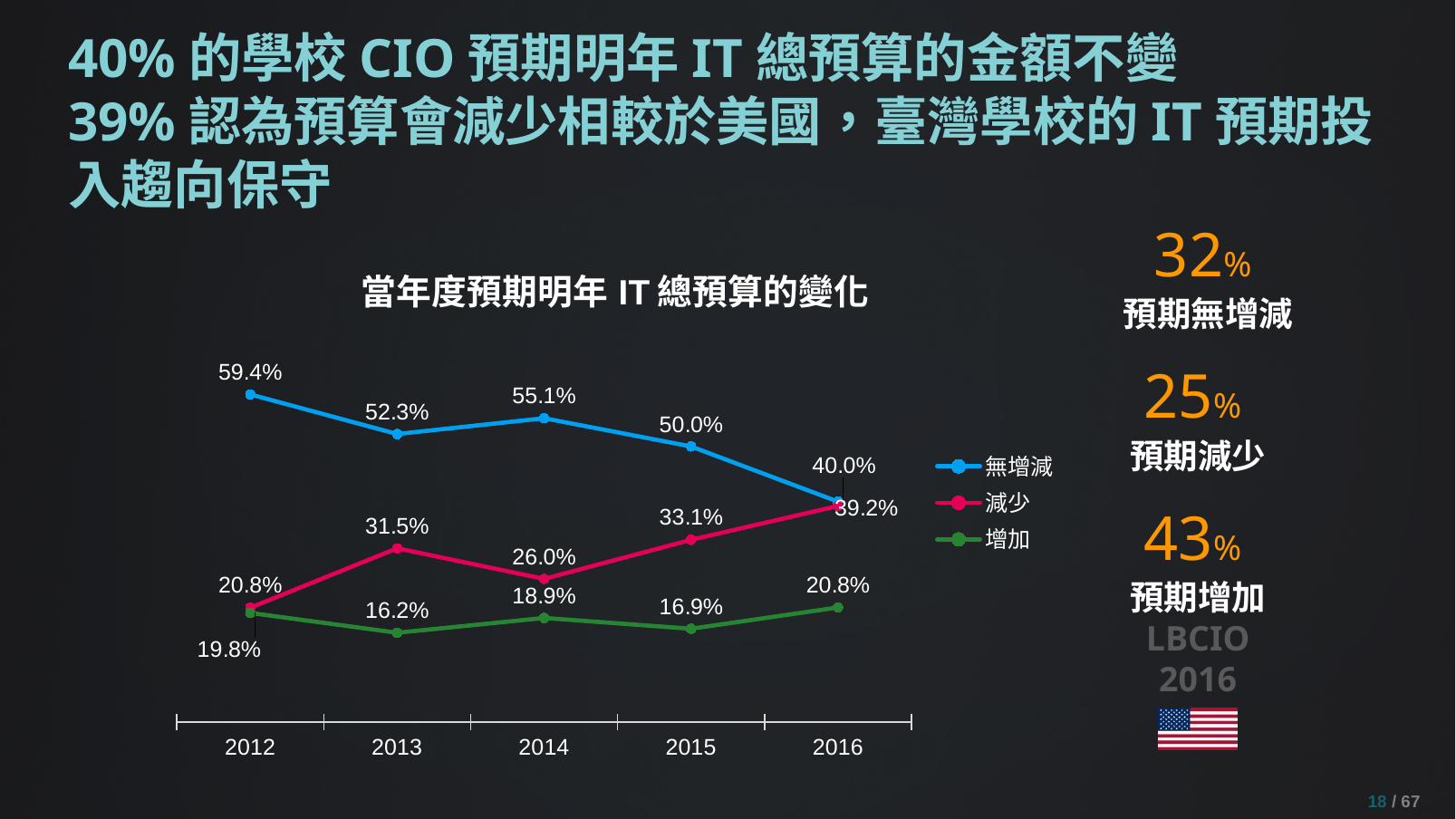
In which year is the 減少 series at its highest? 2016 Which is larger in 2014: the value for 減少 or the value for 增加? 減少 Does the 無增減 series generally rise or fall from 2012 to 2016? fall How many years are shown on the x axis? 5 What type of chart is shown on the slide? line chart In which year is the 無增減 series at its lowest? 2016 What is the value for 減少 in 2016? 39.2% What is the difference between the 無增減 value in 2012 and in 2016? 19.4% How many series does the legend list? 3 What is the value for 增加 in 2013? 16.2% What is the title of the chart? 當年度預期明年 IT 總預算的變化 What is the value for 無增減 in 2012? 59.4%